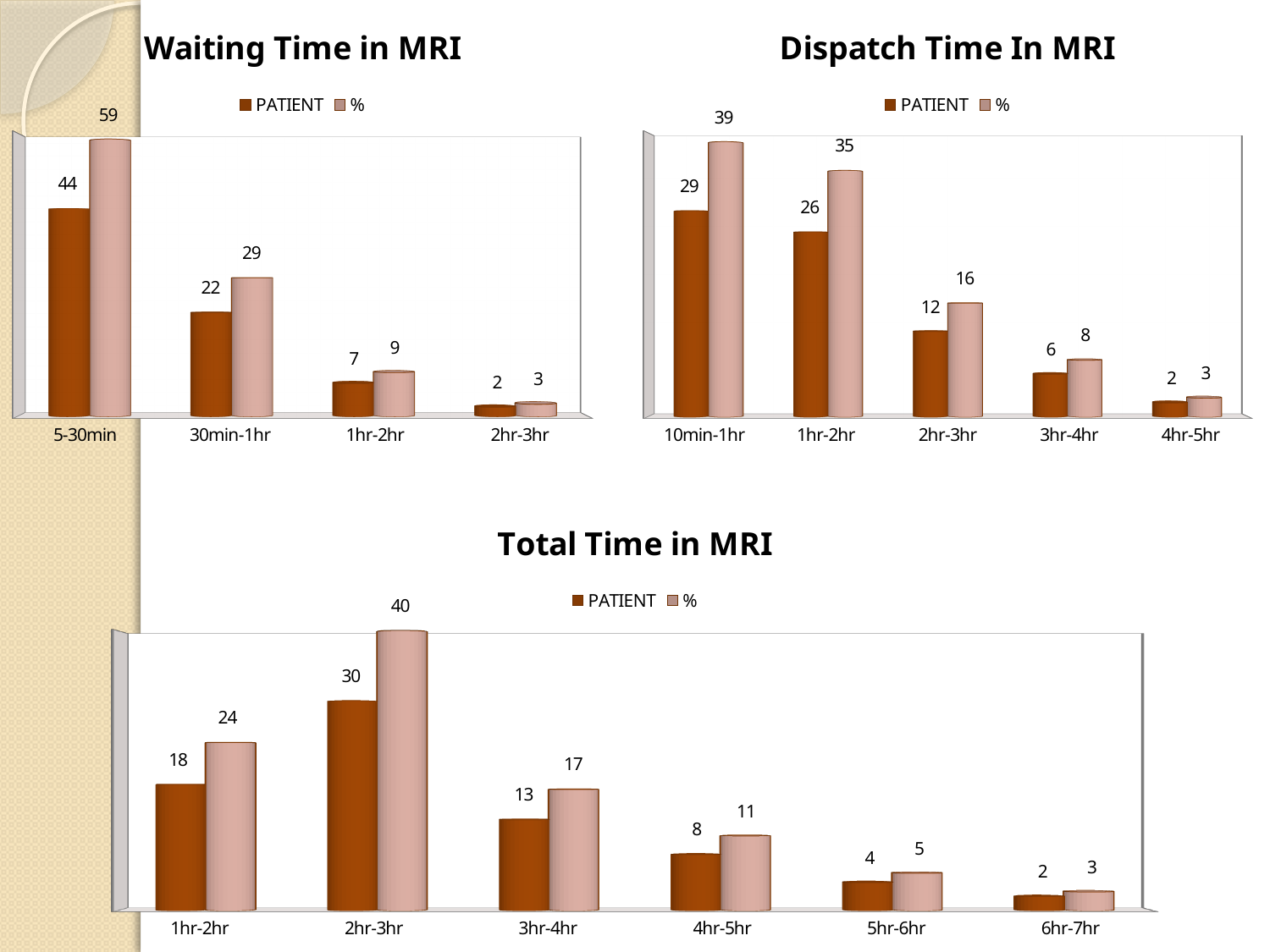
What kind of chart is 'Total Time in MRI'? bar chart In the 'Waiting Time in MRI' chart, what is the PATIENT value for 5-30min? 44 In the 'Waiting Time in MRI' chart, what is the % value for 30min-1hr? 29 In the 'Dispatch Time In MRI' chart, what is the difference between the PATIENT values for 10min-1hr and 1hr-2hr? 3 In the 'Total Time in MRI' chart, is the PATIENT value for 1hr-2hr larger or smaller than the PATIENT value for 3hr-4hr? larger In the 'Dispatch Time In MRI' chart, what is the PATIENT value for 2hr-3hr? 12 In the 'Dispatch Time In MRI' chart, which category has the highest % value? 10min-1hr In the 'Waiting Time in MRI' chart, which category has the lowest PATIENT value? 2hr-3hr In the 'Total Time in MRI' chart, what is the % value for 3hr-4hr? 17 In the 'Waiting Time in MRI' chart, how many categories are shown on the x axis? 4 In the 'Dispatch Time In MRI' chart, how many series does the legend list? 2 In the 'Total Time in MRI' chart, which category has the highest PATIENT value? 2hr-3hr